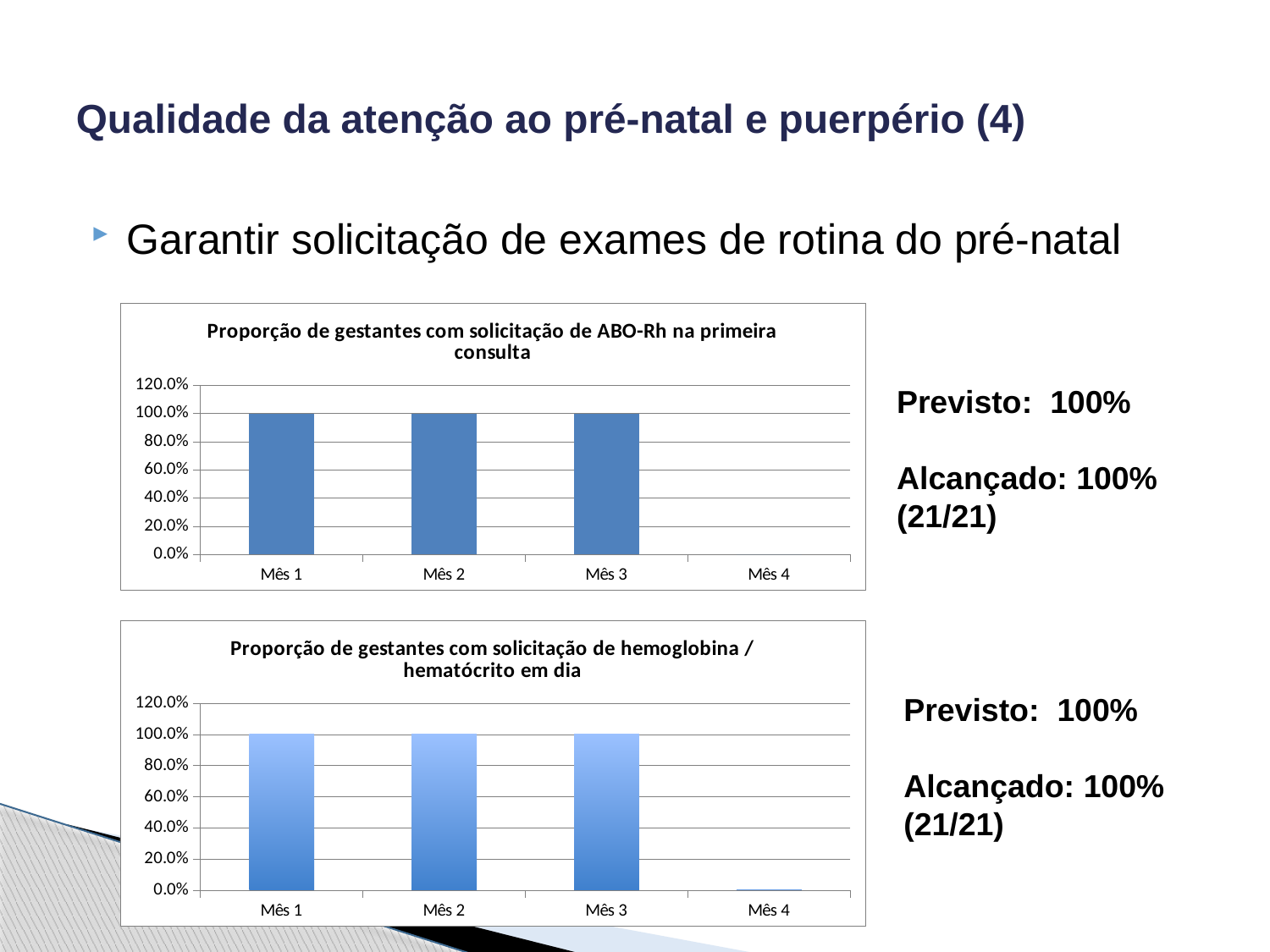
In the top chart (Proporção de gestantes com solicitação de ABO-Rh na primeira consulta), what is the value for Mês 3? 100.0% What is the title of the bottom chart on the slide? Proporção de gestantes com solicitação de hemoglobina / hematócrito em dia In the top chart (Proporção de gestantes com solicitação de ABO-Rh na primeira consulta), what is the value for Mês 1? 100.0% What kind of chart is the top chart (Proporção de gestantes com solicitação de ABO-Rh na primeira consulta)? Bar chart In the top chart (Proporção de gestantes com solicitação de ABO-Rh na primeira consulta), is the value for Mês 2 greater or less than 80.0%? greater What is the highest value shown on the y axis of the bottom chart (Proporção de gestantes com solicitação de hemoglobina / hematócrito em dia)? 120.0% In the bottom chart (Proporção de gestantes com solicitação de hemoglobina / hematócrito em dia), is the value for Mês 4 greater or less than 20.0%? less In the bottom chart (Proporção de gestantes com solicitação de hemoglobina / hematócrito em dia), what is the value for Mês 2? 100.0% How many months (categories) are shown on the x axis of the bottom chart (Proporção de gestantes com solicitação de hemoglobina / hematócrito em dia)? 4 In the top chart (Proporção de gestantes com solicitação de ABO-Rh na primeira consulta), which month has the lowest value? Mês 4 In the bottom chart (Proporção de gestantes com solicitação de hemoglobina / hematócrito em dia), which month has the lowest value? Mês 4 In the top chart (Proporção de gestantes com solicitação de ABO-Rh na primeira consulta), which is larger, the value for Mês 1 or the value for Mês 4? Mês 1